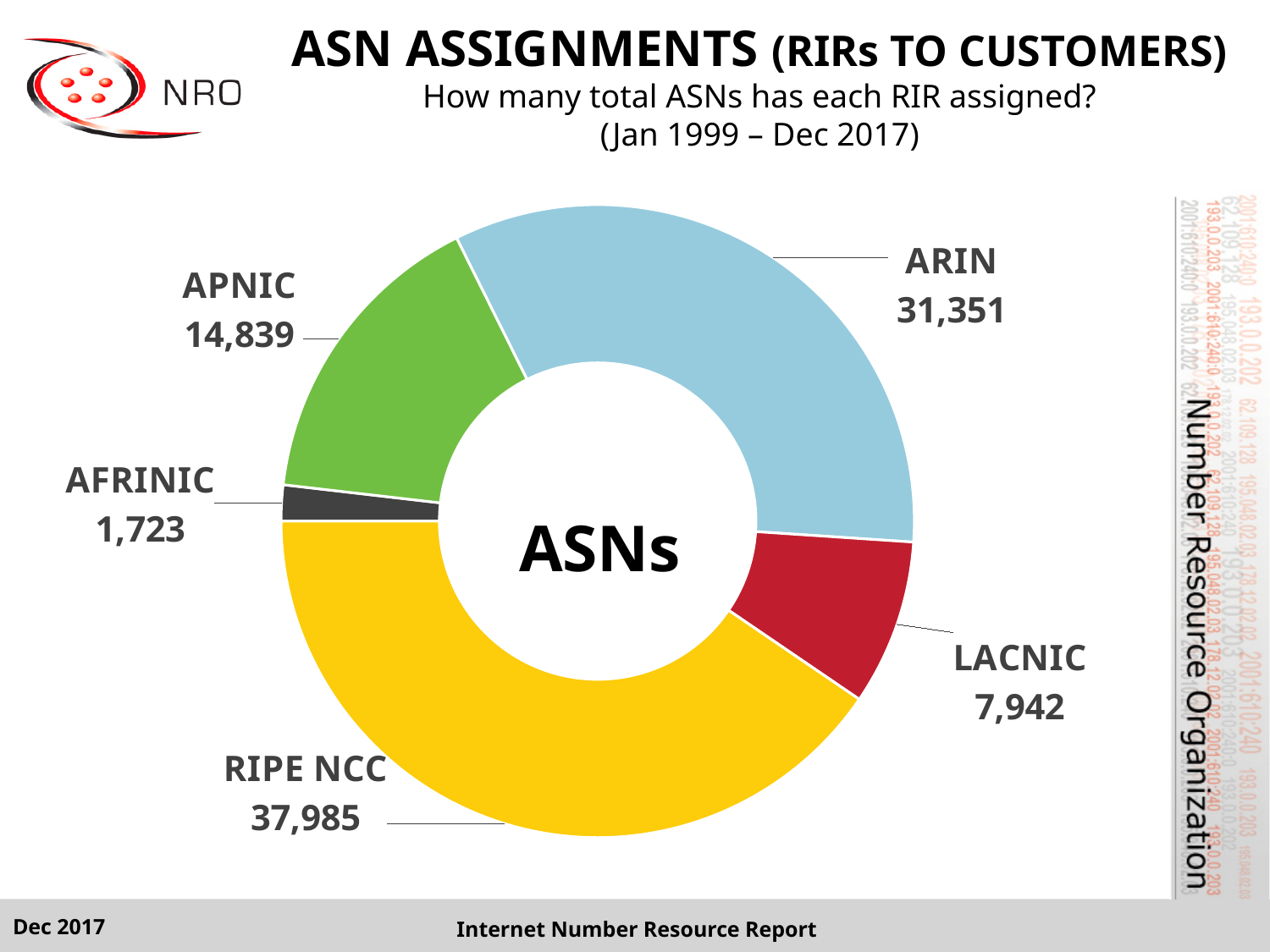
What is the total number of ASNs assigned across all five RIRs shown? 93,840 What is the value shown for RIPE NCC? 37,985 How many more ASNs has RIPE NCC assigned than ARIN? 6,634 What is the difference between the ARIN and APNIC values? 16,512 What kind of chart is shown on the slide? Donut (pie) chart How many ASNs has ARIN assigned according to the chart? 31,351 How many ASNs has AFRINIC assigned? 1,723 Which RIR has assigned the fewest ASNs? AFRINIC What value is shown for LACNIC? 7,942 How many RIRs are shown in the chart? 5 Which RIR has assigned the most ASNs? RIPE NCC Which has assigned more ASNs, APNIC or LACNIC? APNIC